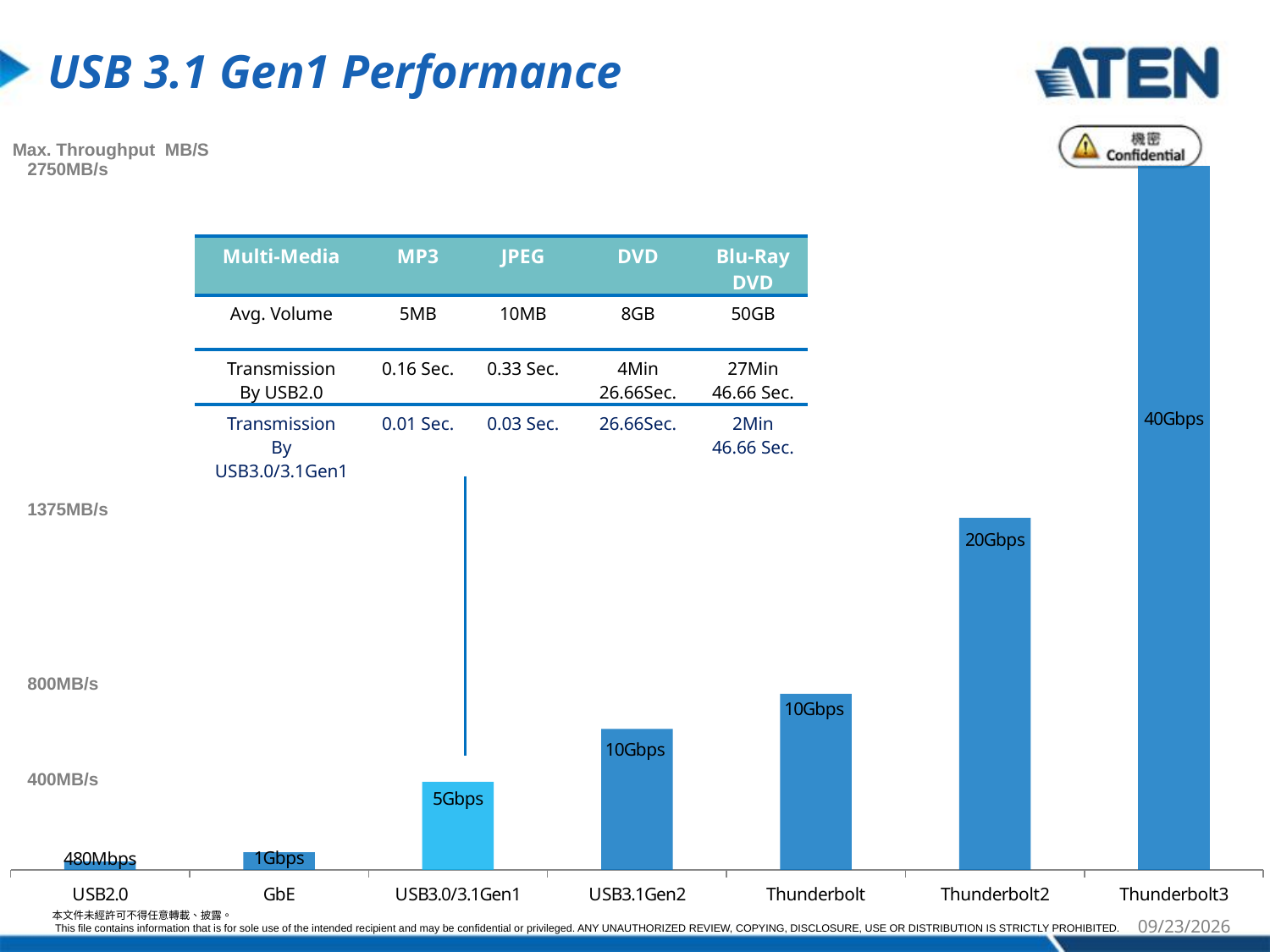
What is the data label on the Thunderbolt3 bar? 40Gbps What is the difference between the Thunderbolt3 and Thunderbolt2 data labels? 20Gbps What is the data label on the USB2.0 bar? 480Mbps Is the value for Thunderbolt3 greater or less than 1375MB/s? greater Which category has the lowest bar in the chart? USB2.0 How many categories are shown on the x axis of the chart? 7 Which is larger, the value for Thunderbolt2 or the value for USB3.1Gen2? Thunderbolt2 What kind of chart is shown on the slide? bar chart What is the data label on the USB3.0/3.1Gen1 bar? 5Gbps Which category has the highest bar in the chart? Thunderbolt3 Which bar in the chart is drawn in a lighter blue than the others? USB3.0/3.1Gen1 What is the data label on the GbE bar? 1Gbps